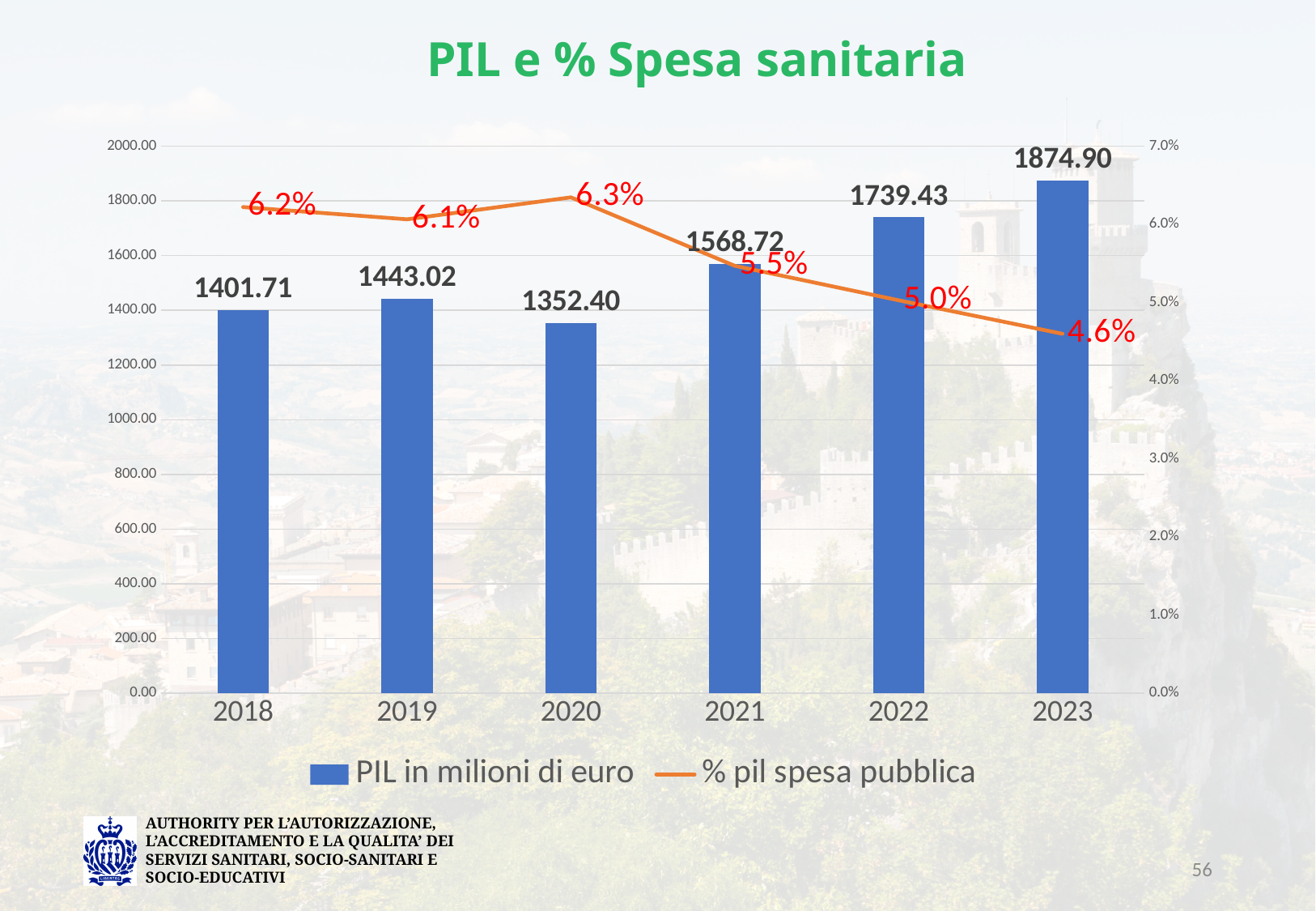
How many series does the legend list? 2 Which year has the lowest % pil spesa pubblica? 2023 Which year has the lowest PIL in milioni di euro? 2020 Does the % pil spesa pubblica rise or fall from 2020 to 2023? fall Which is larger, the PIL in milioni di euro for 2019 or for 2020? 2019 What is the difference in PIL in milioni di euro between 2023 and 2022? 135.47 What is the % pil spesa pubblica value for 2022? 5.0% How many years are shown on the x axis? 6 What is the % pil spesa pubblica value for 2020? 6.3% What is the value of PIL in milioni di euro for 2023? 1874.90 What is the value of PIL in milioni di euro for 2018? 1401.71 Which year has the highest PIL in milioni di euro? 2023